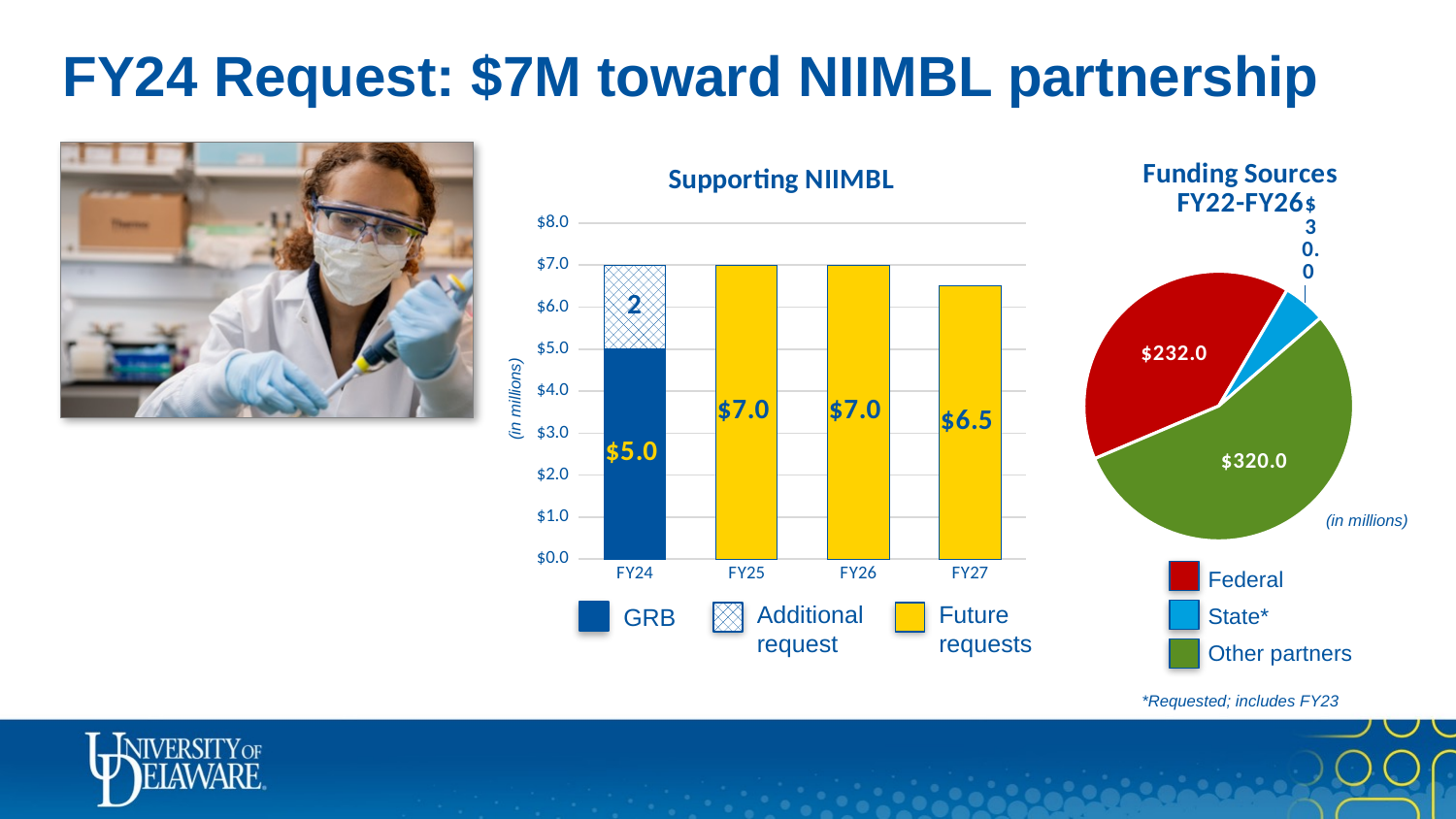
What kind of chart is the 'Funding Sources FY22-FY26' chart? pie chart What kind of chart is the 'Supporting NIIMBL' chart? bar chart In the 'Supporting NIIMBL' chart, what is the value for FY25? $7.0 In the 'Supporting NIIMBL' chart, how many fiscal years are shown on the x axis? 4 In the 'Supporting NIIMBL' chart, what is the difference between the FY25 value and the FY27 value? $0.5 In the 'Supporting NIIMBL' chart, how many series does the legend list? 3 In the 'Funding Sources FY22-FY26' chart, which funding source is the largest slice? Other partners In the 'Supporting NIIMBL' chart, what is the GRB value for FY24? $5.0 In the 'Funding Sources FY22-FY26' chart, what is the value for Other partners? $320.0 In the 'Supporting NIIMBL' chart, which fiscal year has the lowest total bar? FY27 In the 'Supporting NIIMBL' chart, what is the value for FY27? $6.5 In the 'Funding Sources FY22-FY26' chart, what is the difference between the Other partners value and the Federal value? $88.0